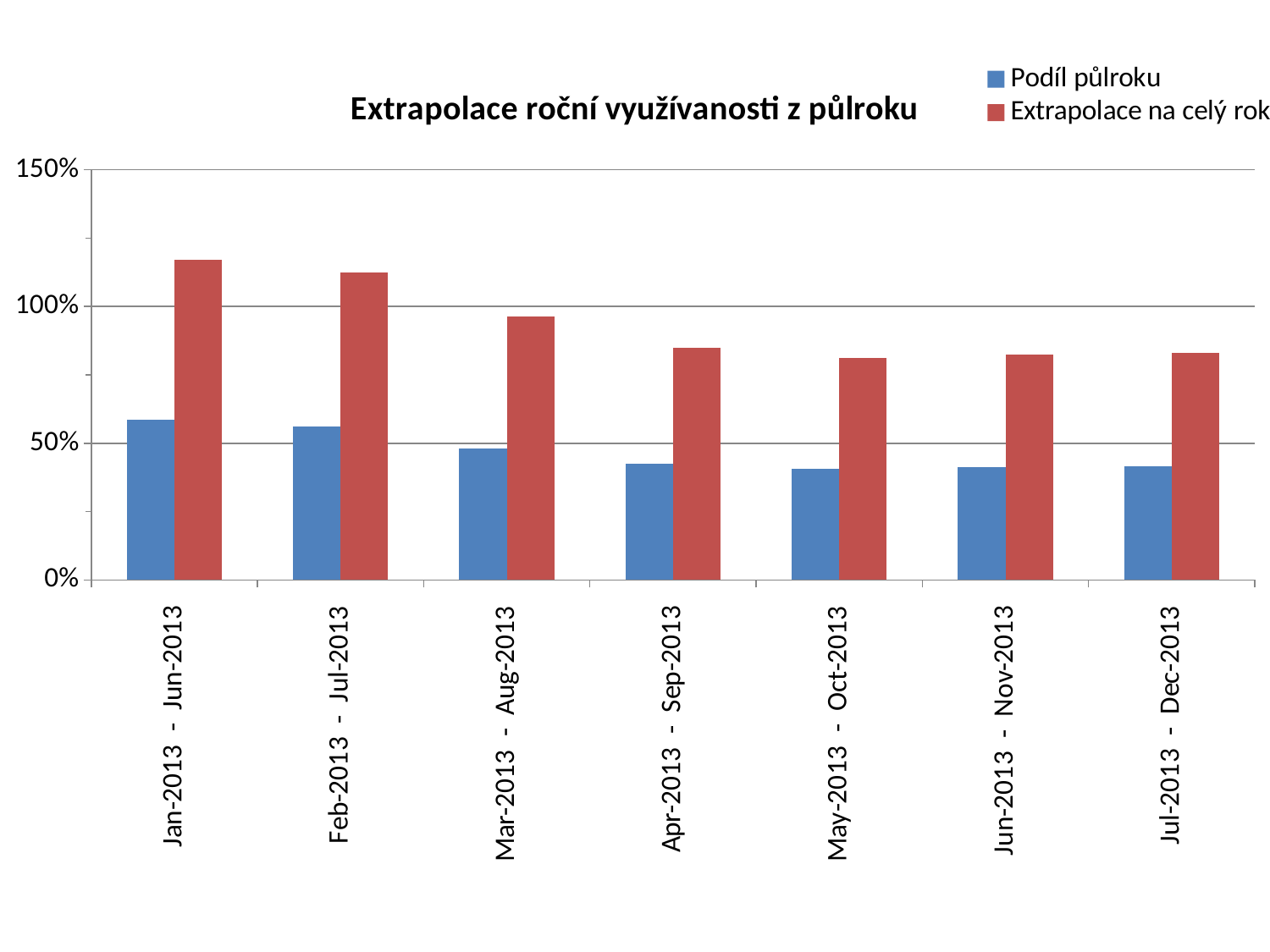
Is the Extrapolace na celý rok value for Jan-2013 - Jun-2013 greater or less than 100%? greater Which is larger: the Extrapolace na celý rok value for Jan-2013 - Jun-2013 or for Mar-2013 - Aug-2013? Jan-2013 - Jun-2013 Which series is shown in red? Extrapolace na celý rok Is the Extrapolace na celý rok value for Apr-2013 - Sep-2013 greater or less than 100%? less For which period is the Extrapolace na celý rok value highest? Jan-2013 - Jun-2013 Do the Extrapolace na celý rok values rise or fall from Jan-2013 - Jun-2013 to Apr-2013 - Sep-2013? fall Is the Podíl půlroku value for Apr-2013 - Sep-2013 greater or less than 50%? less How many periods are shown on the x axis? 7 How many series does the legend list? 2 What kind of chart is shown on the slide? bar chart What is the title of the chart? Extrapolace roční využívanosti z půlroku